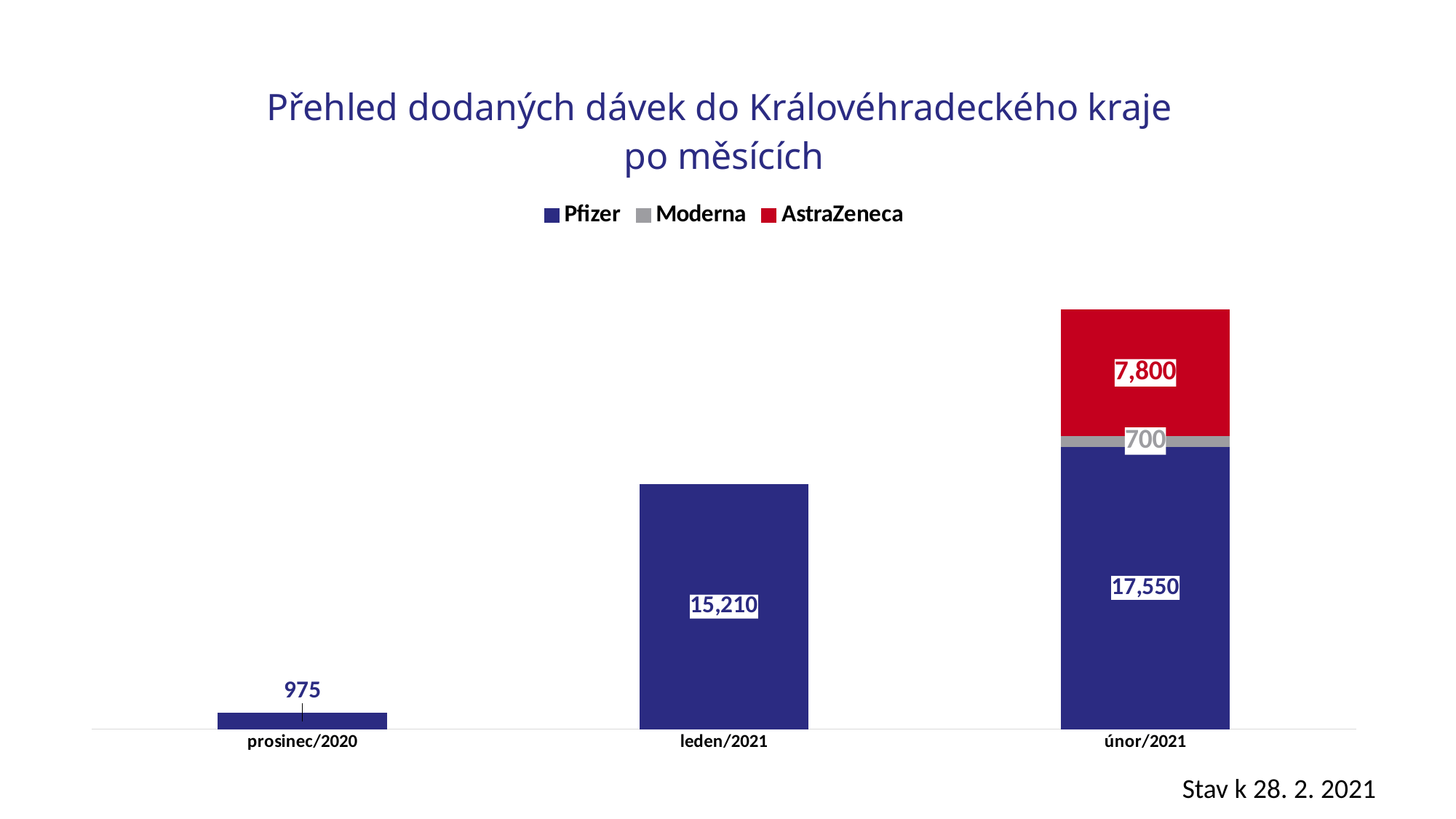
Which month has the highest Pfizer value? únor/2021 Which is larger in únor/2021, the AstraZeneca value or the Moderna value? AstraZeneca How many series does the legend list? 3 How many months are shown on the x axis? 3 What is the total of the stacked bar for únor/2021? 26,050 What is the Pfizer value for leden/2021? 15,210 Which month has the lowest Pfizer value? prosinec/2020 What is the AstraZeneca value for únor/2021? 7,800 What is the difference between the Pfizer values for únor/2021 and leden/2021? 2,340 What kind of chart is shown on the slide? Stacked bar chart What is the Pfizer value for prosinec/2020? 975 What is the Moderna value for únor/2021? 700